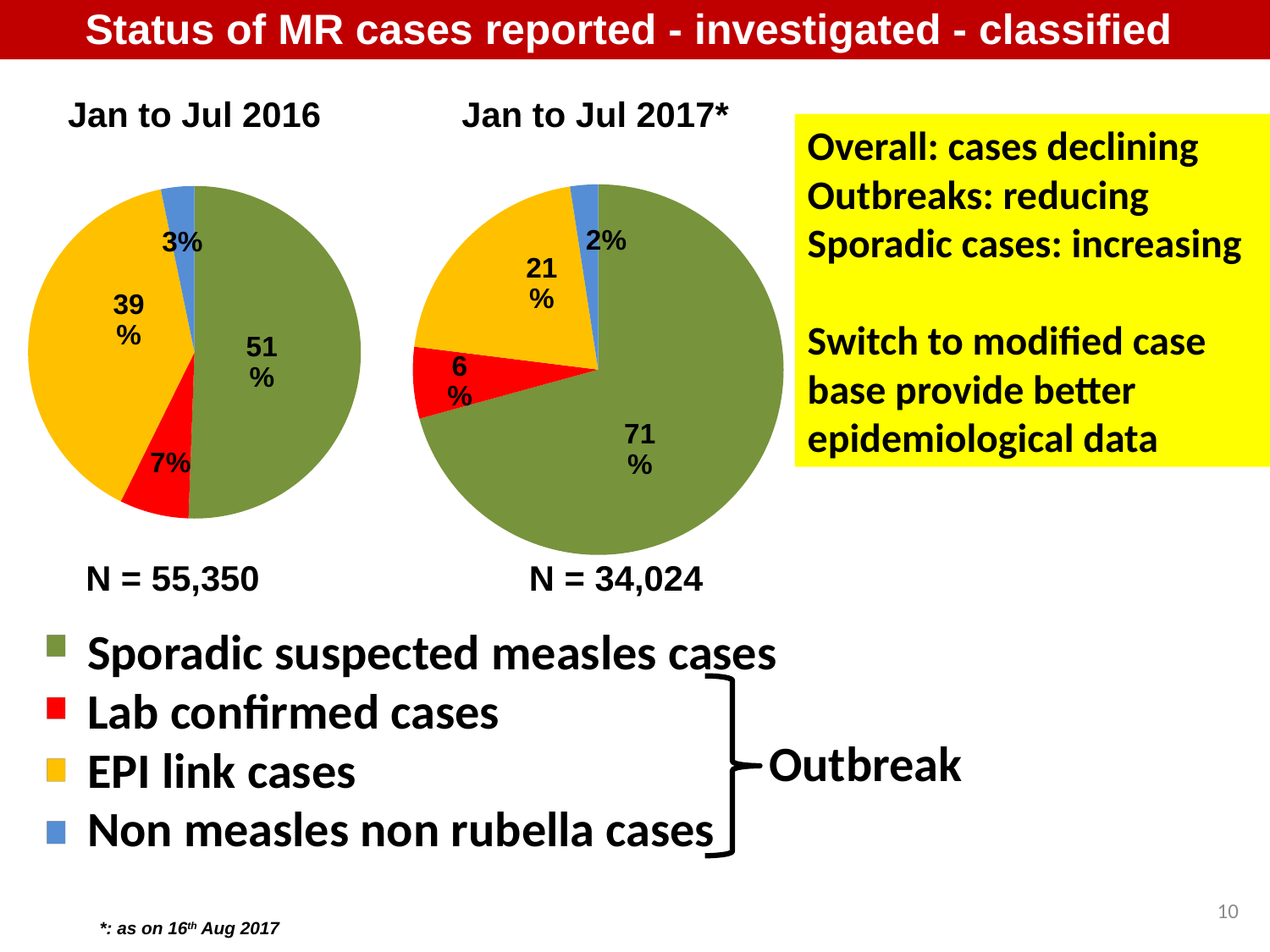
What is the N value shown under the Jan to Jul 2017* pie chart? N = 34,024 In the Jan to Jul 2016 pie chart, what share is EPI link cases? 39% In the Jan to Jul 2016 pie chart, what share is Sporadic suspected measles cases? 51% Which is larger: the Lab confirmed cases share in the Jan to Jul 2016 chart or in the Jan to Jul 2017* chart? Jan to Jul 2016 How many categories does each pie chart show? 4 In the Jan to Jul 2017* pie chart, what share is Non measles non rubella cases? 2% In the Jan to Jul 2016 pie chart, which category has the largest share? Sporadic suspected measles cases In the Jan to Jul 2017* pie chart, which category has the smallest share? Non measles non rubella cases What is the difference between the EPI link cases share in the Jan to Jul 2016 chart and in the Jan to Jul 2017* chart? 18% What type of chart is used for Jan to Jul 2016 and Jan to Jul 2017*? Pie chart In the Jan to Jul 2017* pie chart, what share is Sporadic suspected measles cases? 71% In the Jan to Jul 2017* pie chart, what share is Lab confirmed cases? 6%